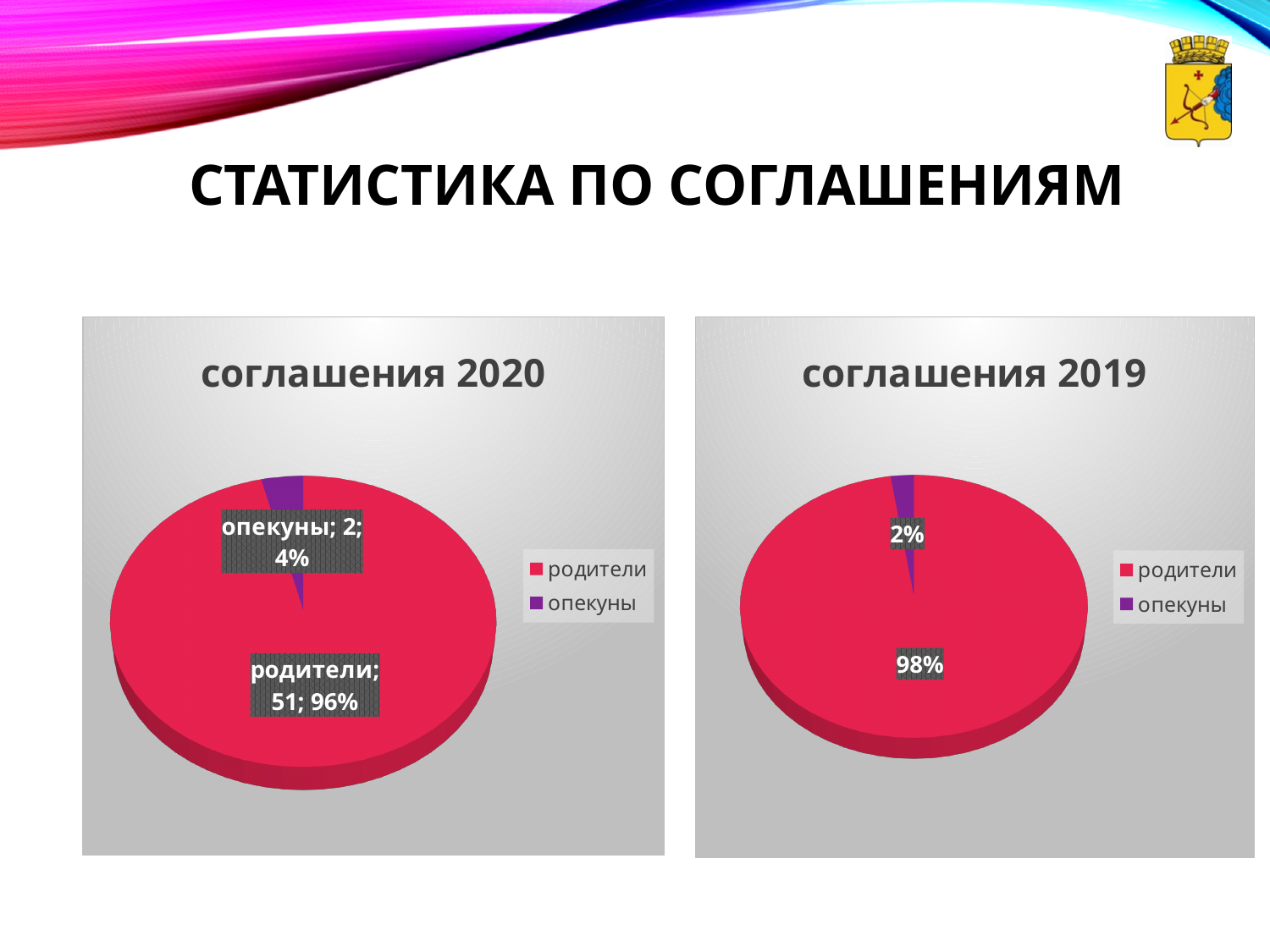
In the 'соглашения 2020' chart, what is the difference between the values for родители and опекуны? 49 In the 'соглашения 2020' chart, what is the value for родители? 51 In the 'соглашения 2020' chart, what is the value for опекуны? 2 In the 'соглашения 2019' chart, what colour is the опекуны slice? purple In the 'соглашения 2019' chart, what share of the pie is родители? 98% In the 'соглашения 2020' chart, what share of the pie is опекуны? 4% In the 'соглашения 2020' chart, what share of the pie is родители? 96% In the 'соглашения 2019' chart, which category is the smallest? опекуны How many categories does the 'соглашения 2020' chart show? 2 In the 'соглашения 2020' chart, which category is the largest? родители What kind of chart is the 'соглашения 2019' chart? pie chart